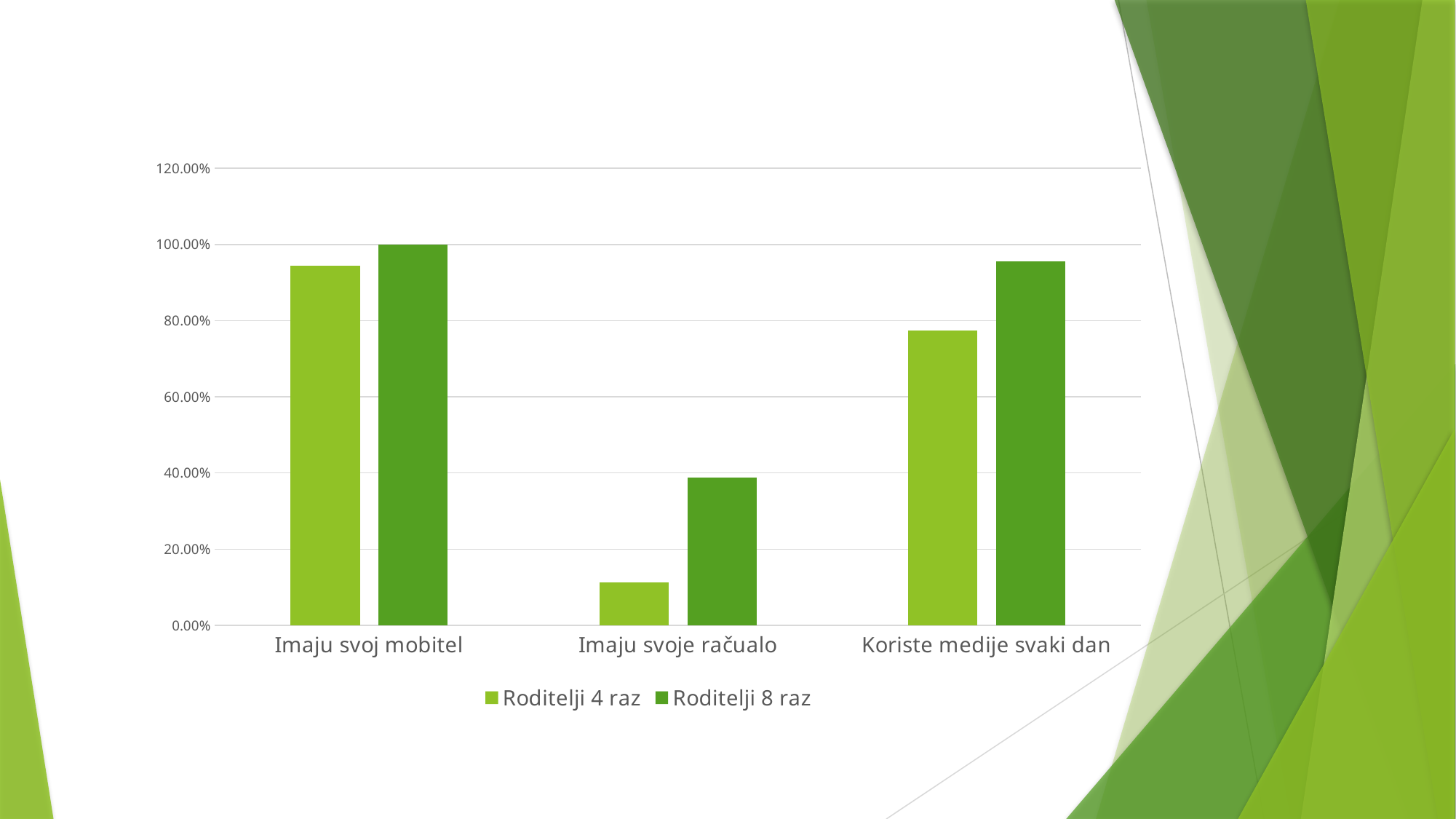
What kind of chart is shown on the slide? bar chart Is the value for Roditelji 4 raz in Imaju svoj mobitel greater or less than 80.00%? greater Which category has the lowest value for the Roditelji 4 raz series? Imaju svoje račualo Is the value for Roditelji 4 raz in Imaju svoje račualo greater or less than 20.00%? less Which category has the highest value for the Roditelji 8 raz series? Imaju svoj mobitel Which category has the lowest value for the Roditelji 8 raz series? Imaju svoje račualo What are the two series named in the legend? Roditelji 4 raz and Roditelji 8 raz Is the value for Roditelji 8 raz in Koriste medije svaki dan greater or less than 80.00%? greater How many series does the legend list? 2 How many categories are shown on the x axis? 3 For Imaju svoje račualo, which series has the larger value, Roditelji 4 raz or Roditelji 8 raz? Roditelji 8 raz For Koriste medije svaki dan, which series has the larger value, Roditelji 4 raz or Roditelji 8 raz? Roditelji 8 raz